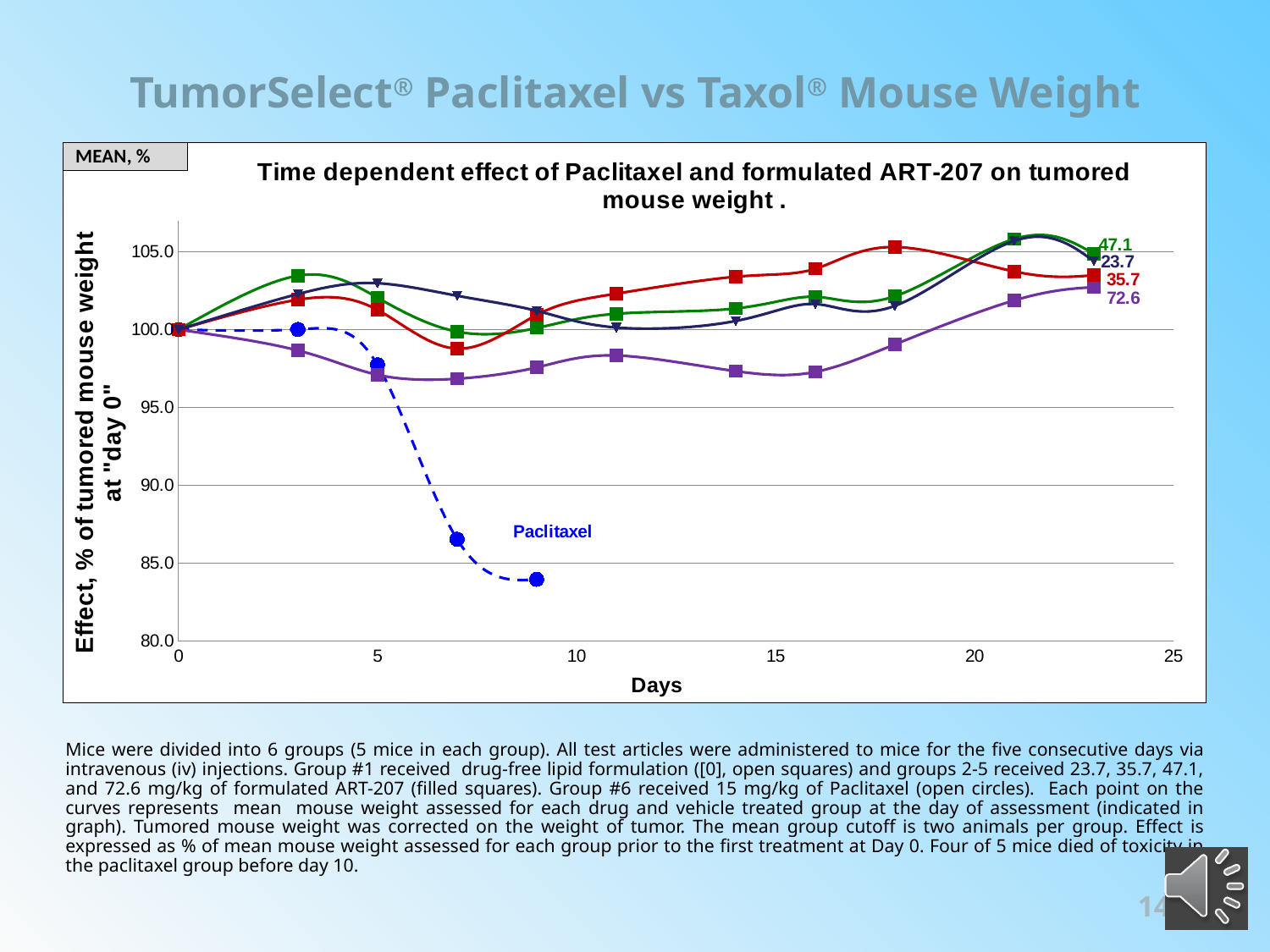
Which series has the lowest value at day 9? Paclitaxel How many data points does the Paclitaxel series have? 5 How many labeled series are plotted on the chart? 5 Is the value of the Paclitaxel series at day 7 greater or less than 85.0? greater What is the label of the x axis of the chart? Days What value do all the series share at day 0? 100.0 What is the title of the chart? Time dependent effect of Paclitaxel and formulated ART-207 on tumored mouse weight . What kind of chart is shown on the slide? line chart Is the value of the 72.6 series at day 7 greater or less than 95.0? greater Is the value of the 72.6 series at day 16 greater or less than 100.0? less Does the Paclitaxel series rise or fall from day 0 to day 9? fall